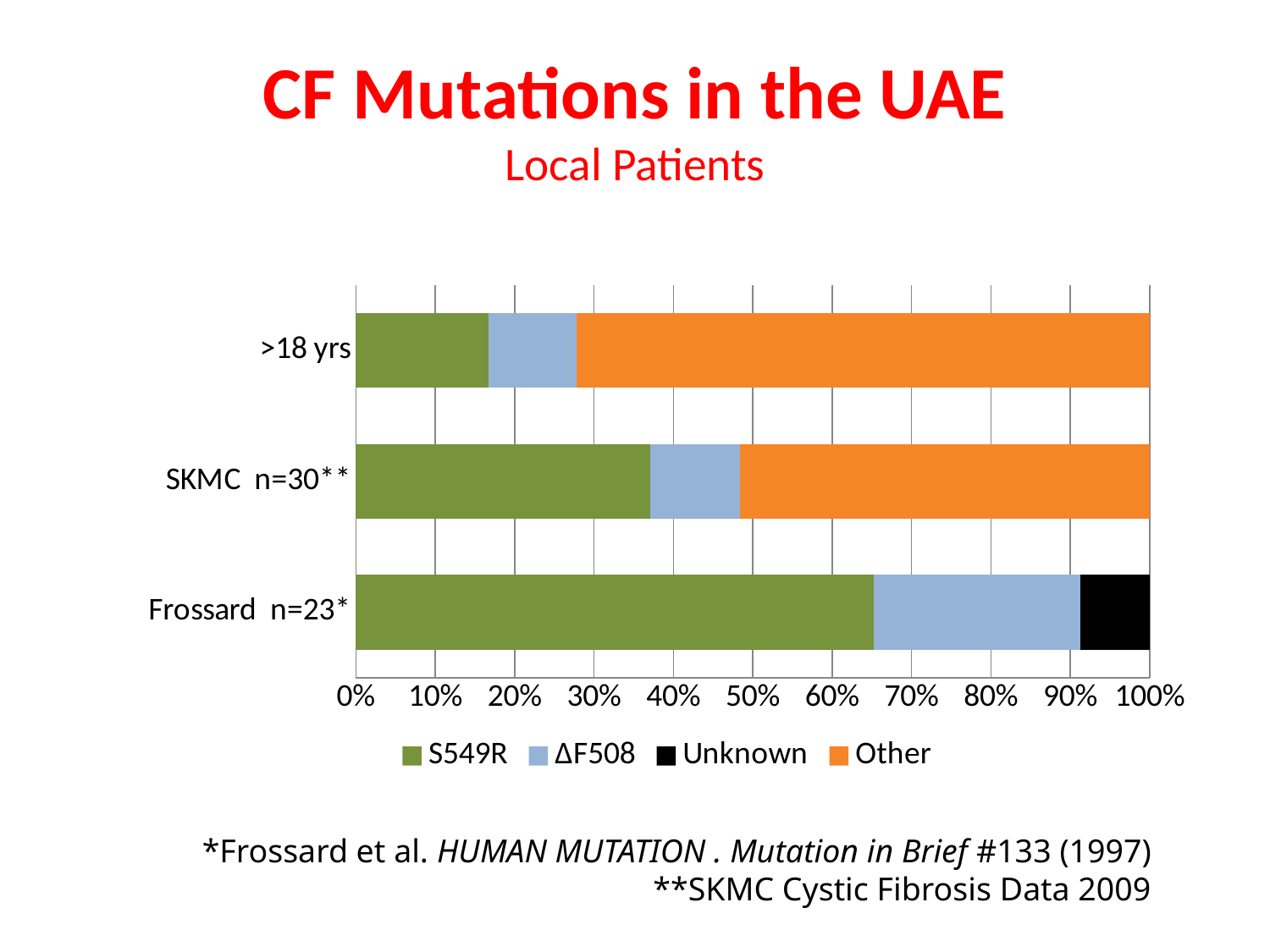
How many series does the legend list? 4 Which category is the only one with an Unknown segment? Frossard n=23* What is the total of the stacked bar for SKMC n=30**? 100% Is the S549R share for SKMC n=30** greater or less than 30%? greater Which is larger: the Other share for >18 yrs or the Other share for SKMC n=30**? >18 yrs Which category has the largest S549R share? Frossard n=23* Is the S549R share for Frossard n=23* greater or less than 60%? greater Which category has the smallest S549R share? >18 yrs How many categories (bars) are plotted in the chart? 3 What kind of chart is shown on the slide? stacked bar chart What is the main title of the slide? CF Mutations in the UAE Is the S549R share for >18 yrs greater or less than 20%? less